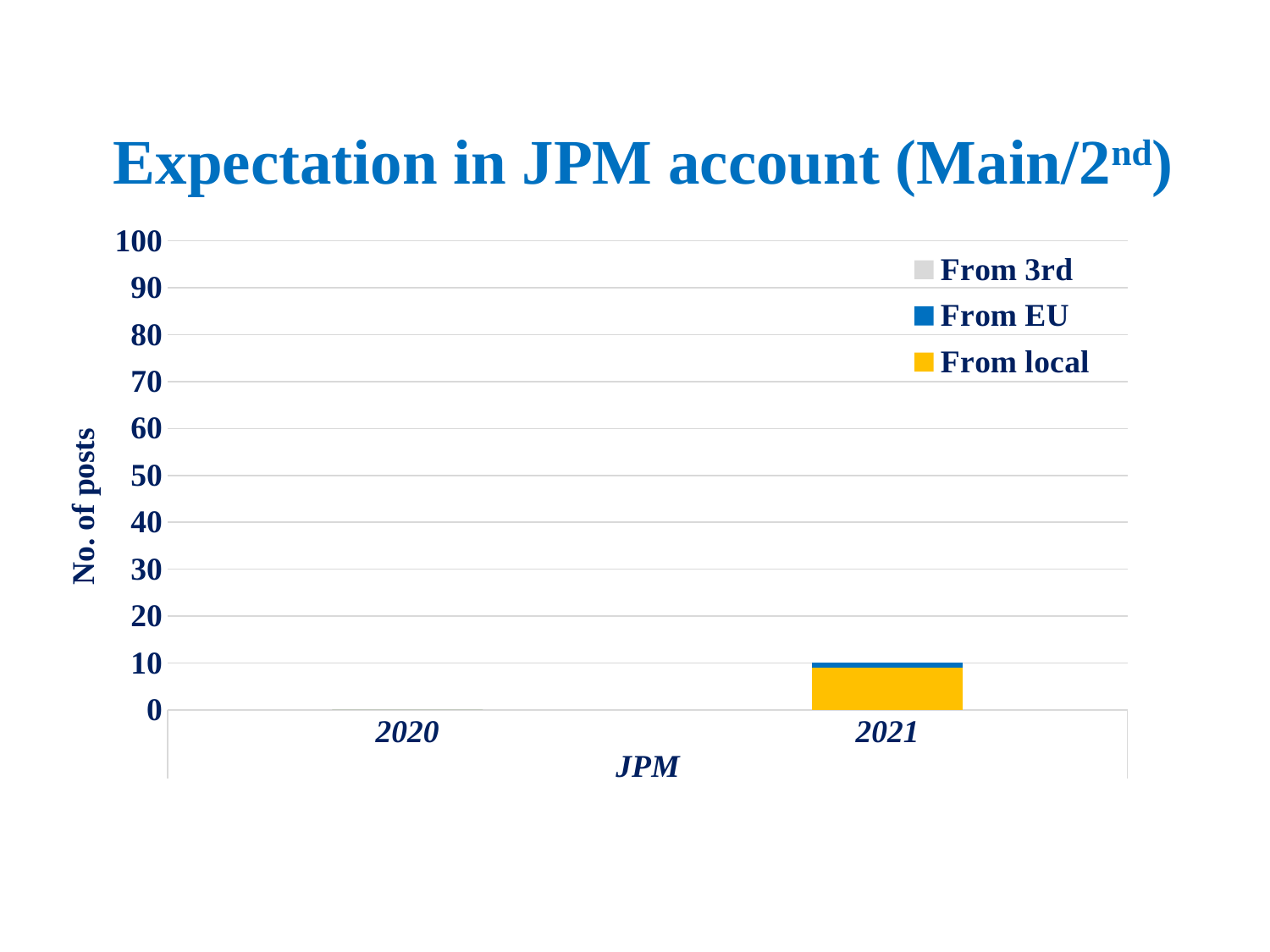
Is the total height of the stacked bar for 2021 greater or less than 50? less Which series is shown in yellow in the legend? From local How many series does the legend list? 3 Which year has the taller stacked bar, 2020 or 2021? 2021 How many categories are shown on the x axis? 2 What is the label of the y axis? No. of posts Is the total height of the stacked bar for 2021 greater or less than 20? less What kind of chart is shown on the slide? bar chart What is the highest value shown on the y axis? 100 Is the value for From local in 2021 greater or less than 30? less Which series forms the largest part of the 2021 bar? From local